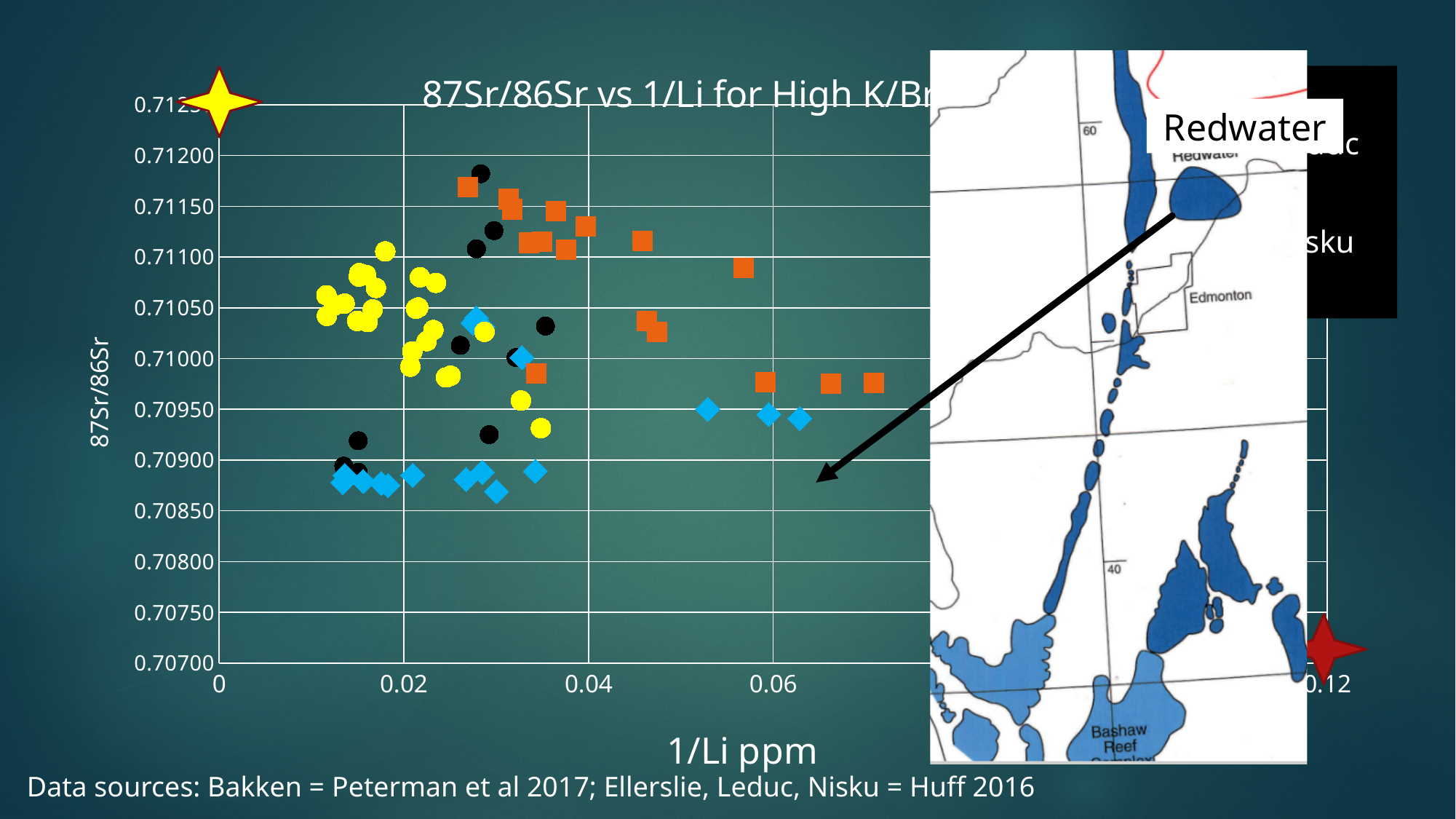
Is the lowest blue diamond marker greater or less than 0.70900 on the 87Sr/86Sr axis? less Is the highest yellow circle marker greater or less than 0.71150 on the 87Sr/86Sr axis? less Are all the blue diamond markers above or below 0.71100 on the 87Sr/86Sr axis? below What is the title of the horizontal axis of the chart? 1/Li ppm How many different marker colours are plotted on the chart? 4 Which marker group extends furthest to the right along the 1/Li ppm axis? orange squares What kind of chart is shown on the slide? scatter chart What is the title of the vertical axis of the chart? 87Sr/86Sr